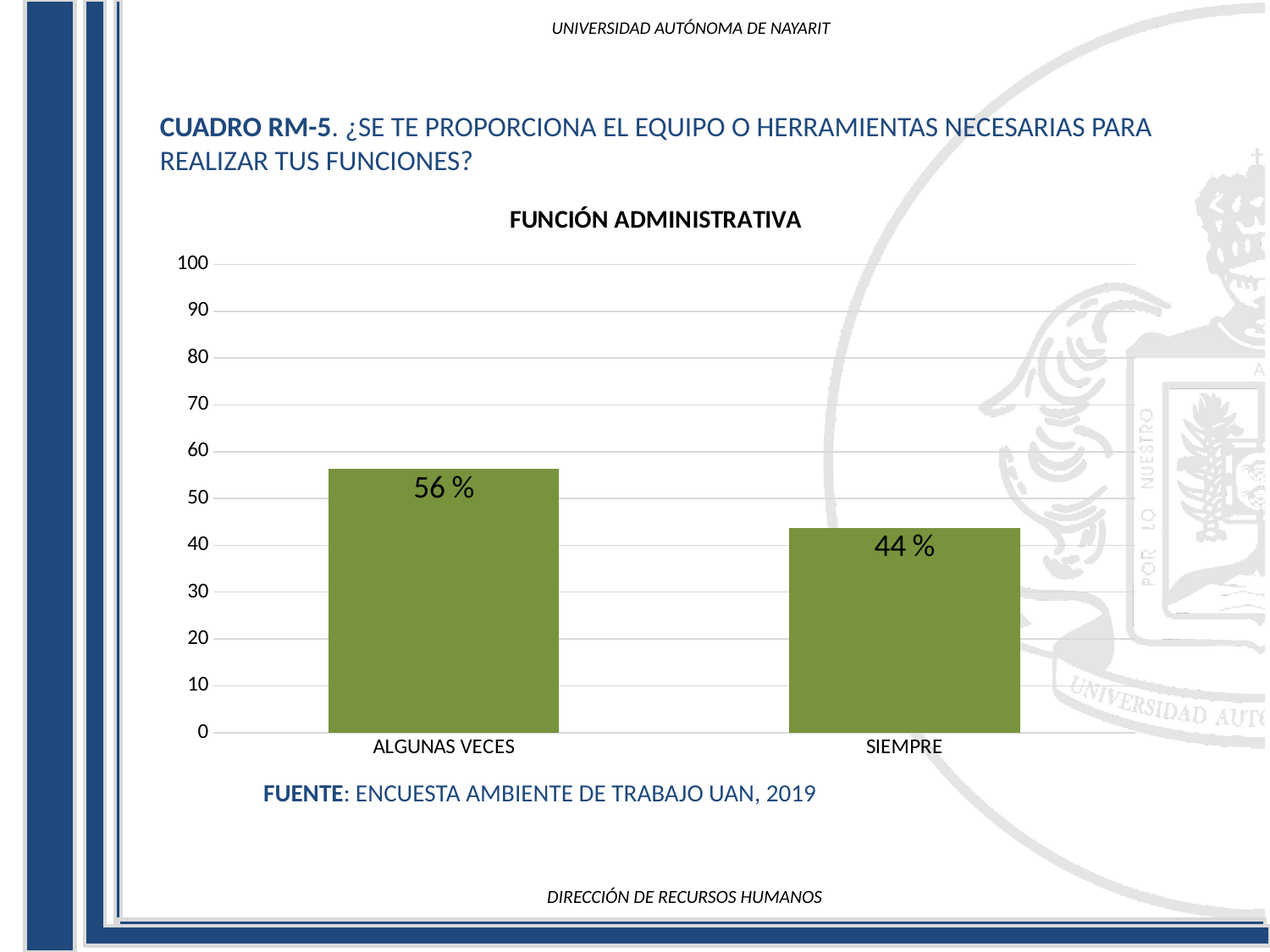
Is the value for ALGUNAS VECES greater or less than 50? greater What is the highest value shown on the y axis? 100 What is the title of the chart? FUNCIÓN ADMINISTRATIVA What is the difference between the values for ALGUNAS VECES and SIEMPRE? 12 % What kind of chart is shown on the slide? bar chart How many categories are shown on the x axis? 2 Is the value for SIEMPRE greater or less than 50? less Which category has the lowest value? SIEMPRE What is the value for SIEMPRE? 44 % What is the value for ALGUNAS VECES? 56 % Which is larger, the value for ALGUNAS VECES or the value for SIEMPRE? ALGUNAS VECES Which category has the highest value? ALGUNAS VECES